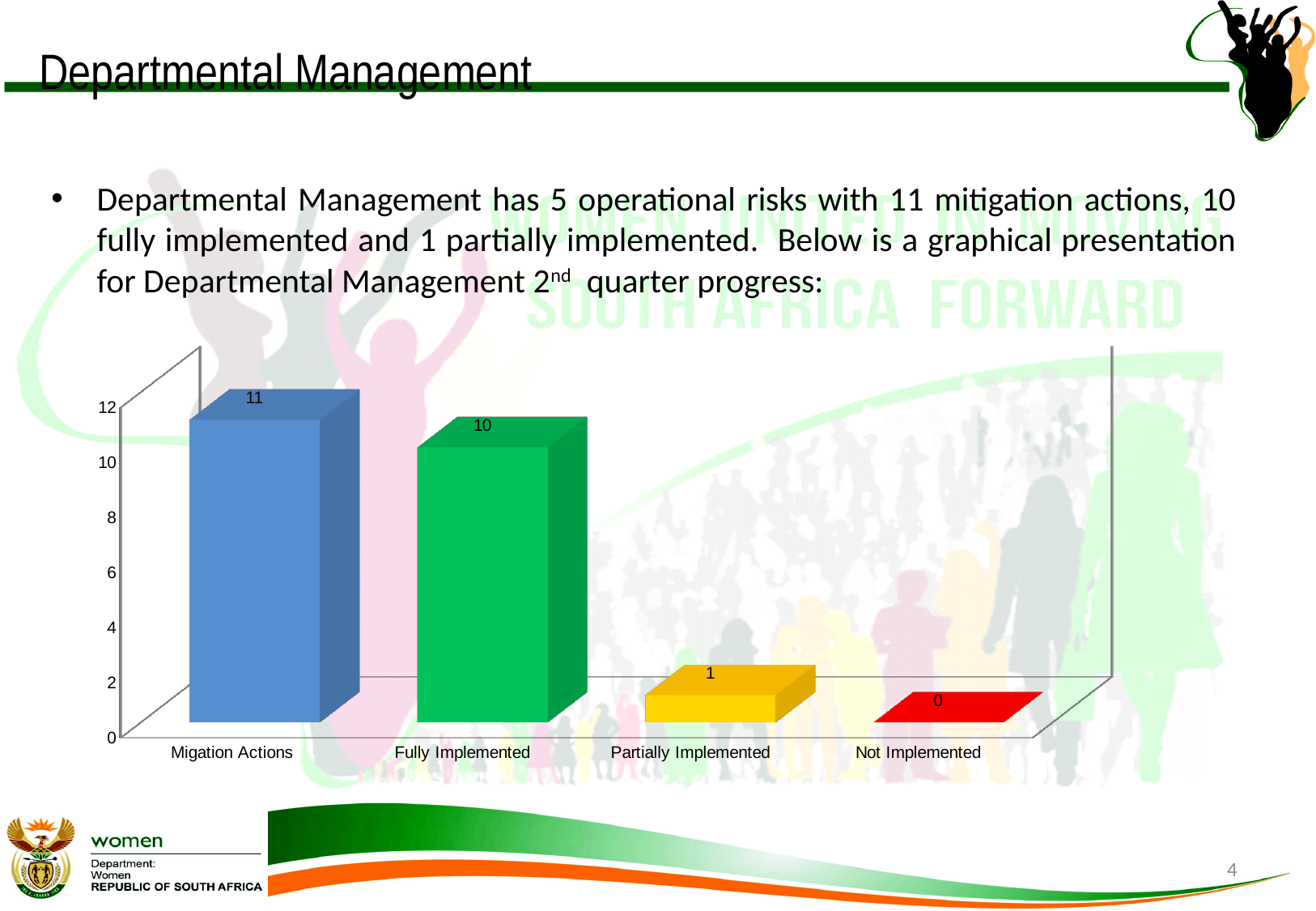
What is the value for Not Implemented? 0 Do the values rise or fall from left to right across the categories? fall Which is larger, the value for Fully Implemented or the value for Partially Implemented? Fully Implemented Which category has the lowest value? Not Implemented What kind of chart is shown on the slide? bar chart What is the value for Fully Implemented? 10 What is the value for Migation Actions? 11 What is the difference between the values for Migation Actions and Fully Implemented? 1 What is the difference between the values for Fully Implemented and Partially Implemented? 9 How many categories are shown on the chart? 4 Which category has the highest value? Migation Actions What is the value for Partially Implemented? 1